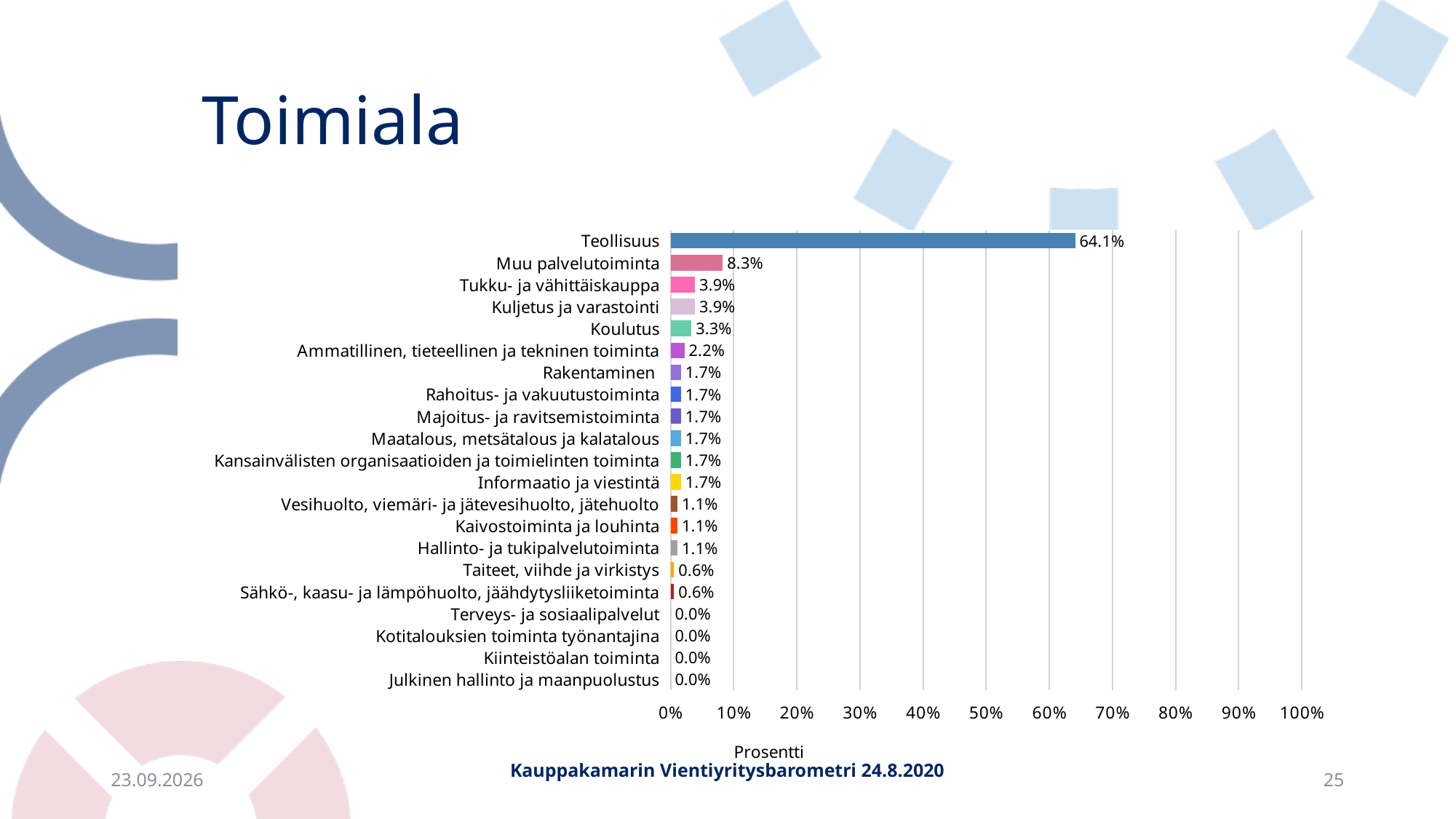
What is the value for Kaivostoiminta ja louhinta? 1.1% How many categories are shown in the chart? 21 Is the value for Teollisuus greater or less than 60%? greater What is the difference between the values for Teollisuus and Muu palvelutoiminta? 55.8% What is the value for Muu palvelutoiminta? 8.3% Which is larger, the value for Koulutus or the value for Rakentaminen? Koulutus What is the value for Ammatillinen, tieteellinen ja tekninen toiminta? 2.2% What kind of chart is shown on the slide? bar chart Which category has the highest value? Teollisuus What is the label of the horizontal axis? Prosentti What is the value for Teollisuus? 64.1% What is the value for Koulutus? 3.3%